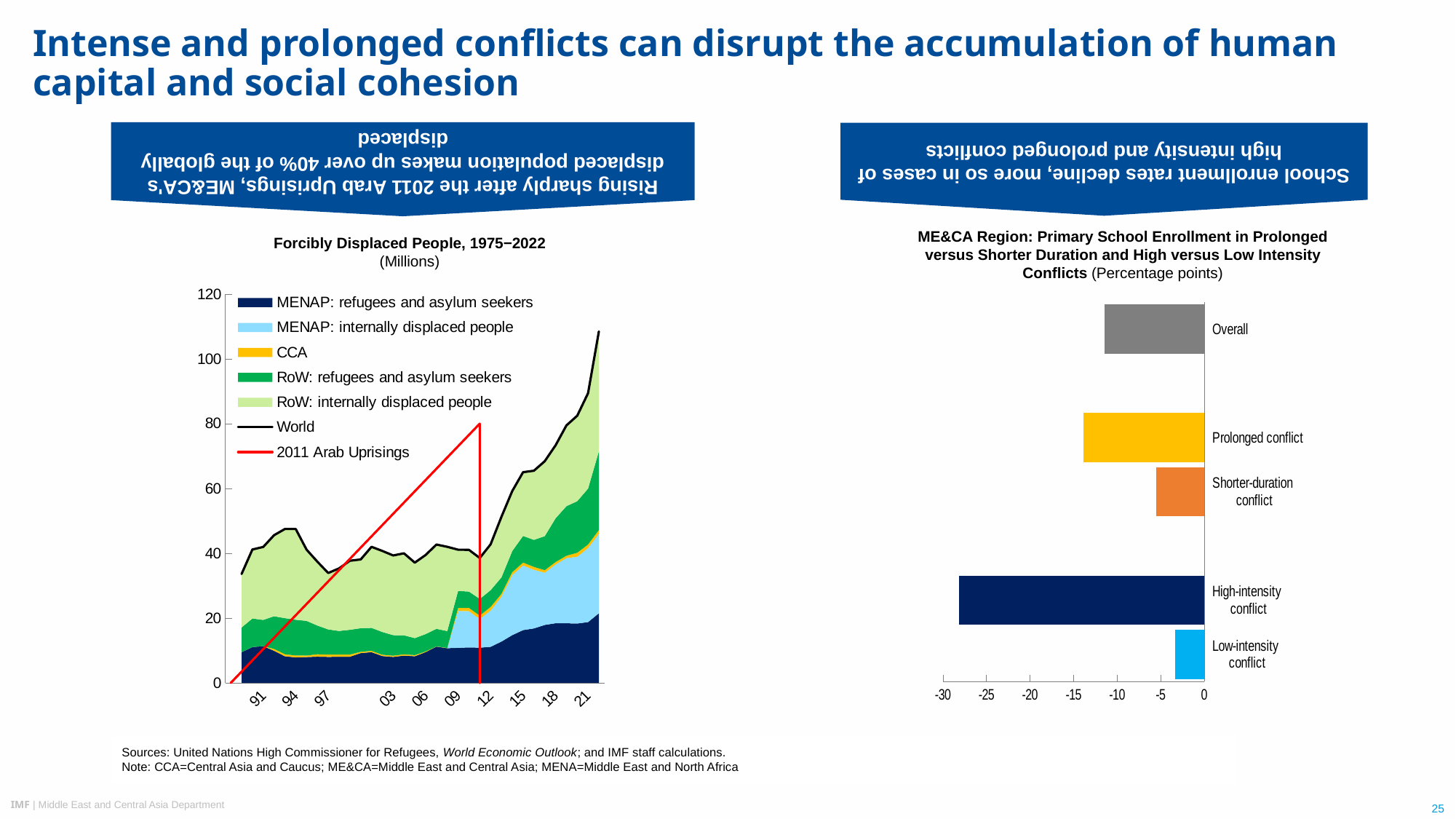
On the right chart, which category has the smallest decline in primary school enrollment? Low-intensity conflict What unit is shown under the title of the left chart? Millions On the right chart, is the value for High-intensity conflict greater or less than -25? less How many categories are shown on the right chart? 5 What kind of chart is the right chart? Bar chart On the right chart, is the value for Low-intensity conflict greater or less than -5? greater On the left chart, is the World value in 2022 greater or less than 100? greater On the left chart, does the World line generally rise or fall between 2012 and 2022? rise On the right chart, which category has the largest decline in primary school enrollment? High-intensity conflict On the right chart, which shows a larger decline, Prolonged conflict or Shorter-duration conflict? Prolonged conflict How many entries does the legend of the left chart list? 7